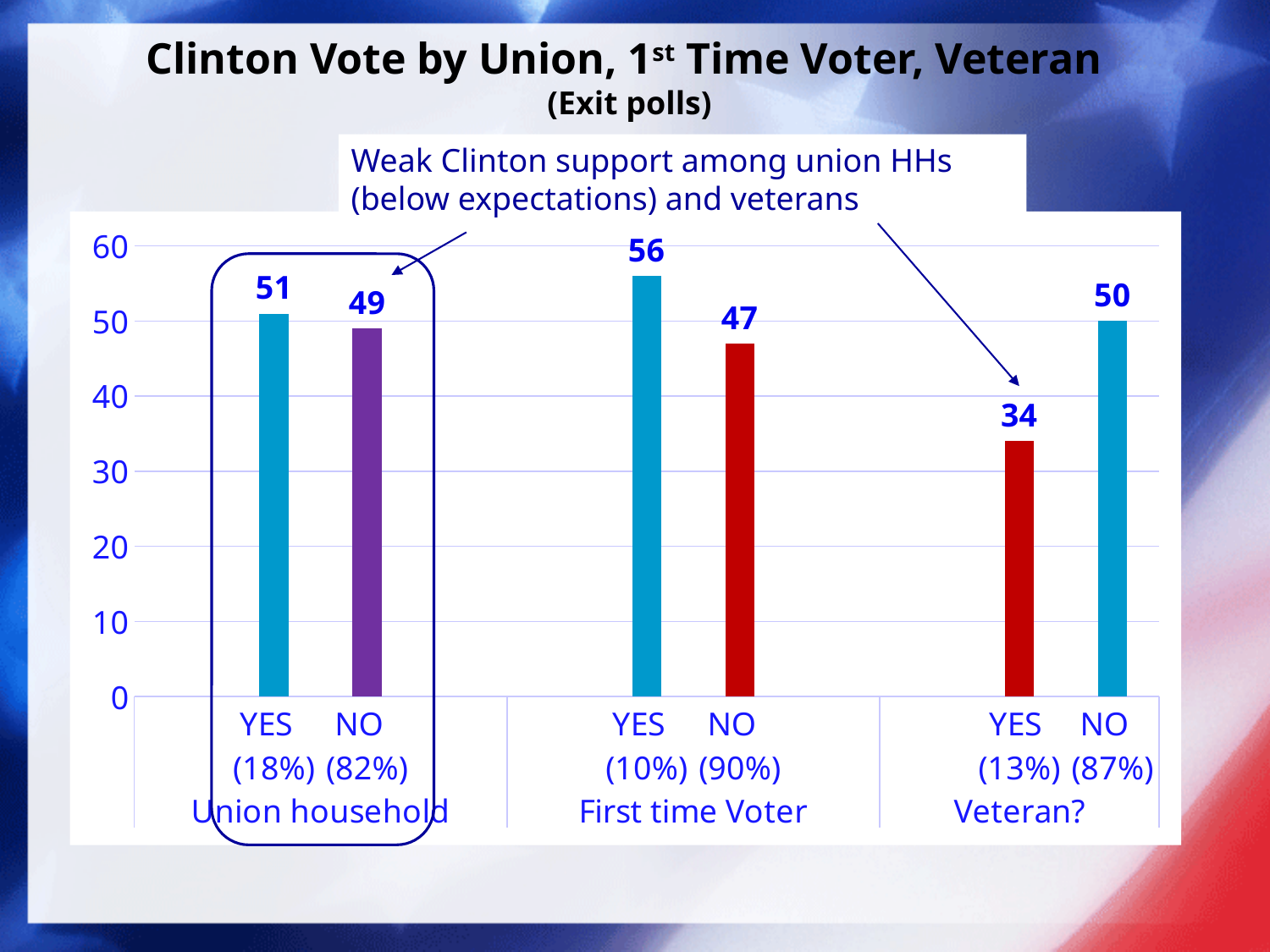
What is the difference between the Veteran? NO value and the Veteran? YES value? 16 Which is larger, the Union household YES value or the Union household NO value? Union household YES What kind of chart is shown on the slide? Bar chart What share of respondents were in a union household (YES), as shown in the axis label? 18% Which bar has the highest value on the chart? First time Voter YES What is the Clinton vote value for Union household YES? 51 What is the difference between the First time Voter YES value and the First time Voter NO value? 9 How many bars are plotted on the chart? 6 What is the Clinton vote value for Veteran? NO? 50 What is the Clinton vote value for First time Voter YES? 56 Which bar has the lowest value on the chart? Veteran? YES What is the Clinton vote value for Veteran? YES? 34